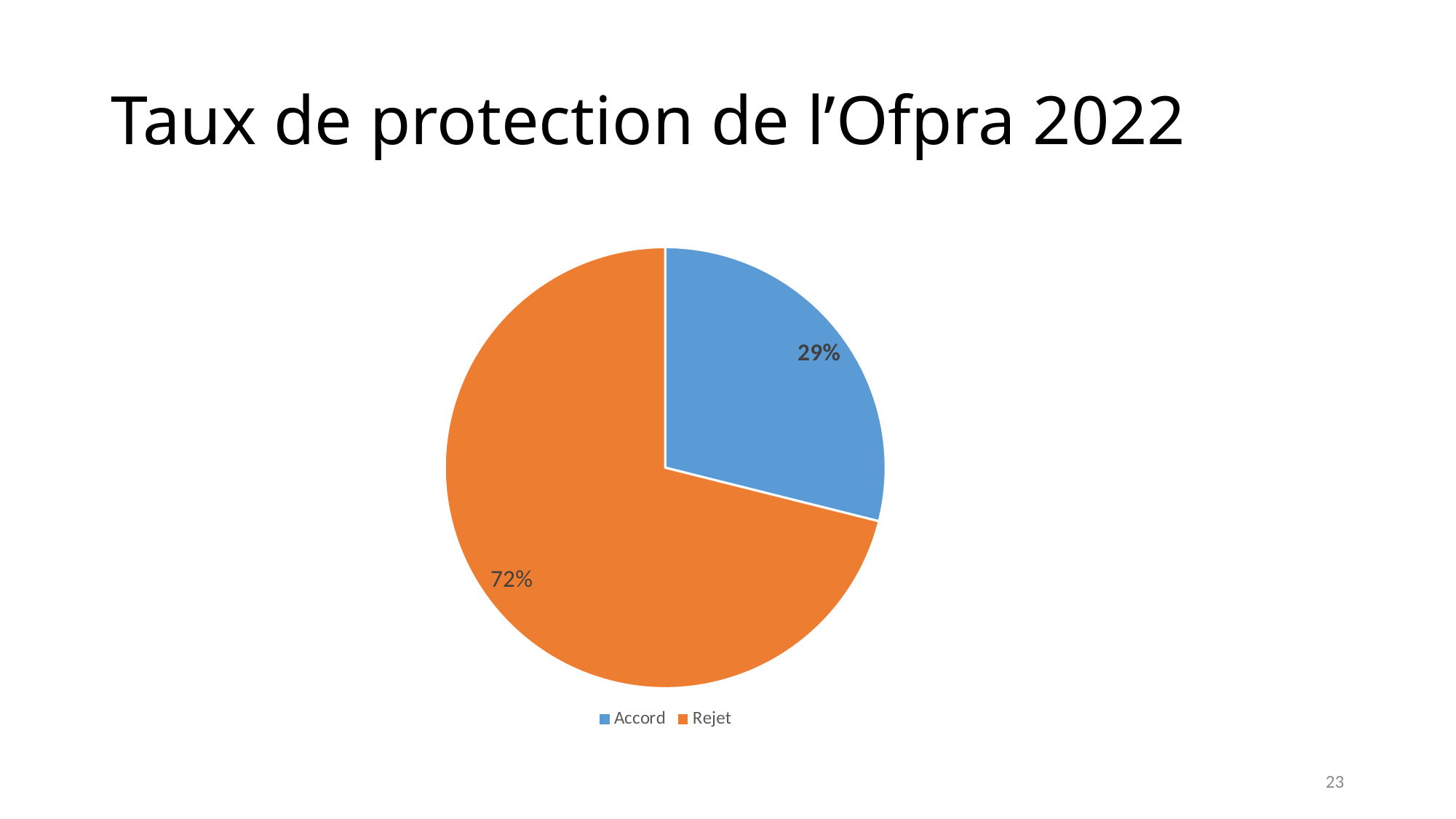
How many slices does the pie chart have? 2 What share of the pie does Rejet represent? 72% Which is larger, Accord or Rejet? Rejet What colour is the Rejet slice? orange What share of the pie does Accord represent? 29% What kind of chart is shown on the slide? pie chart How many entries does the legend list? 2 Which slice is the smallest? Accord What is the title of the slide? Taux de protection de l’Ofpra 2022 What is the difference in percentage points between Rejet and Accord? 43 Which slice is the largest? Rejet